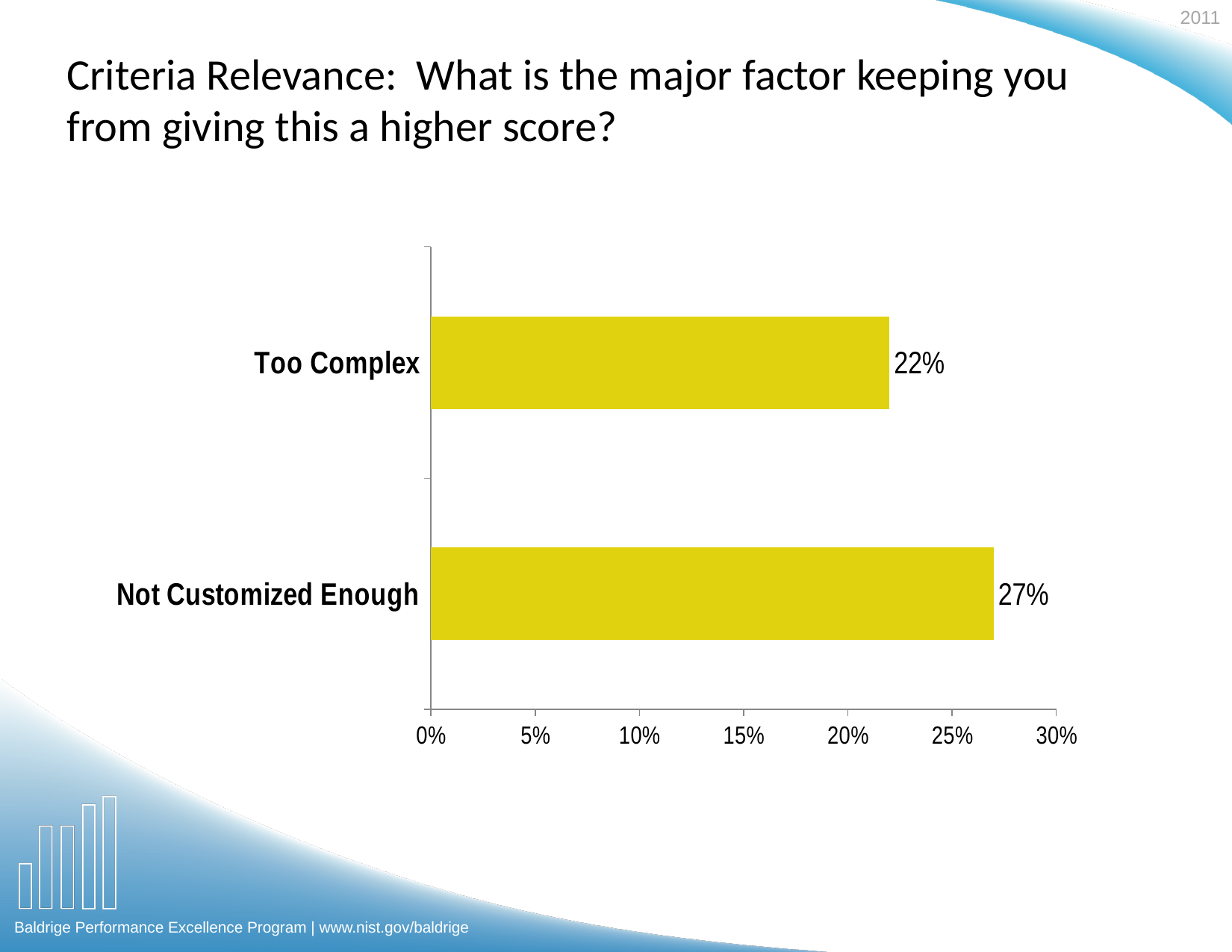
Which category has the highest value? Not Customized Enough What kind of chart is shown on the slide? bar chart Which is larger, the value for Too Complex or the value for Not Customized Enough? Not Customized Enough What is the value for Not Customized Enough? 27% How many categories are shown in the chart? 2 Is the value for Not Customized Enough greater or less than 25%? greater What is the value for Too Complex? 22% What is the difference between the values for Not Customized Enough and Too Complex? 5% What is the maximum value shown on the horizontal axis? 30% What colour are the bars in the chart? yellow Which category has the lowest value? Too Complex Is the value for Too Complex greater or less than 25%? less